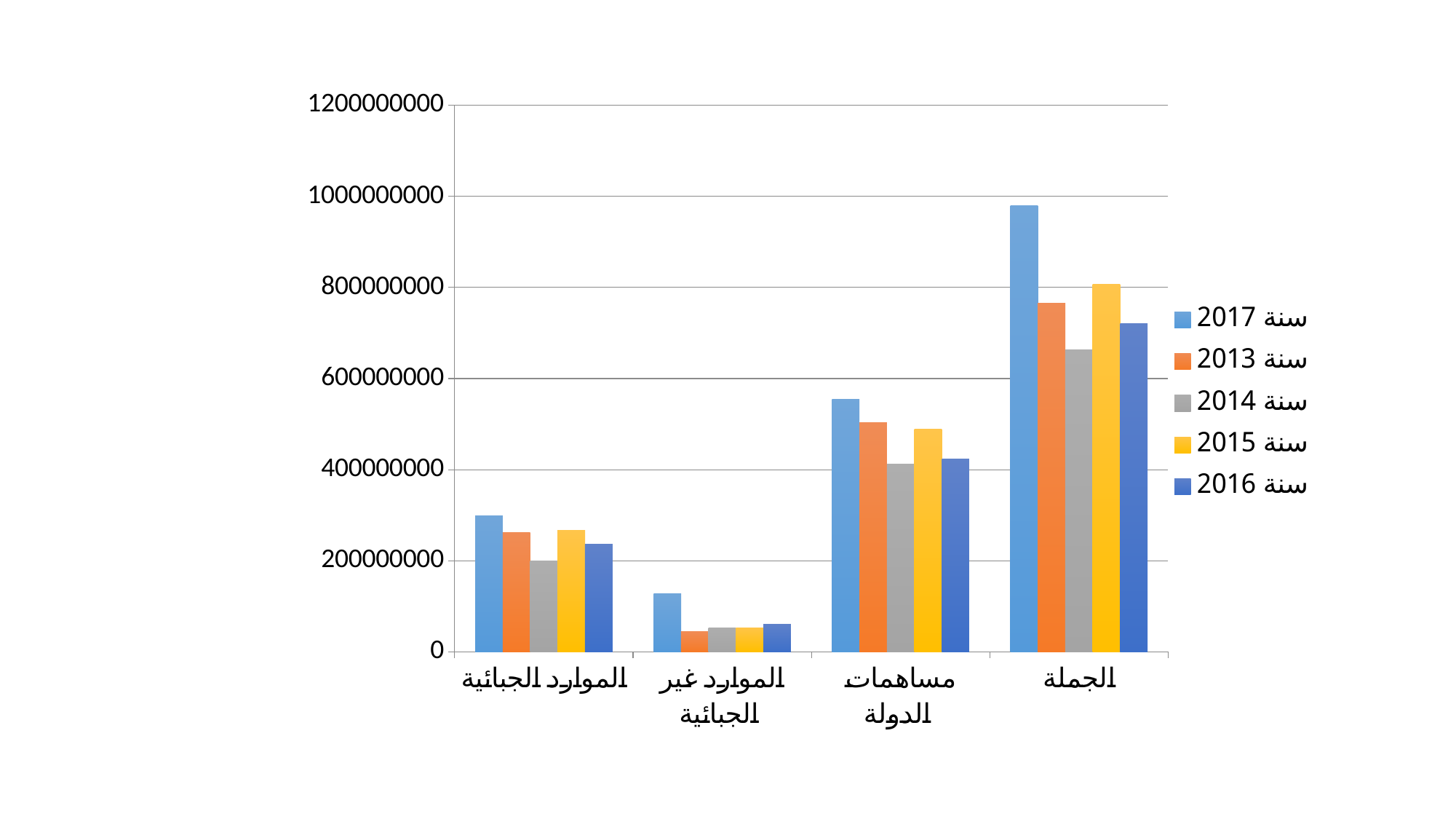
Which category has the lowest value for سنة 2013? الموارد غير الجبائية What kind of chart is shown on the slide? bar chart Which series has the highest bar in the الجملة category? سنة 2017 How many categories are shown on the x axis? 4 Which series is shown in yellow in the legend? سنة 2015 In the الجملة category, which is larger: the value for سنة 2013 or سنة 2015? سنة 2015 Is the value for سنة 2017 in مساهمات الدولة greater or less than 600000000? less Which category has the highest value for سنة 2017? الجملة Which series has the lowest bar in the الجملة category? سنة 2014 How many series does the legend list? 5 Is the value for سنة 2017 in الموارد غير الجبائية greater or less than 200000000? less Is the value for سنة 2017 in الجملة greater or less than 800000000? greater